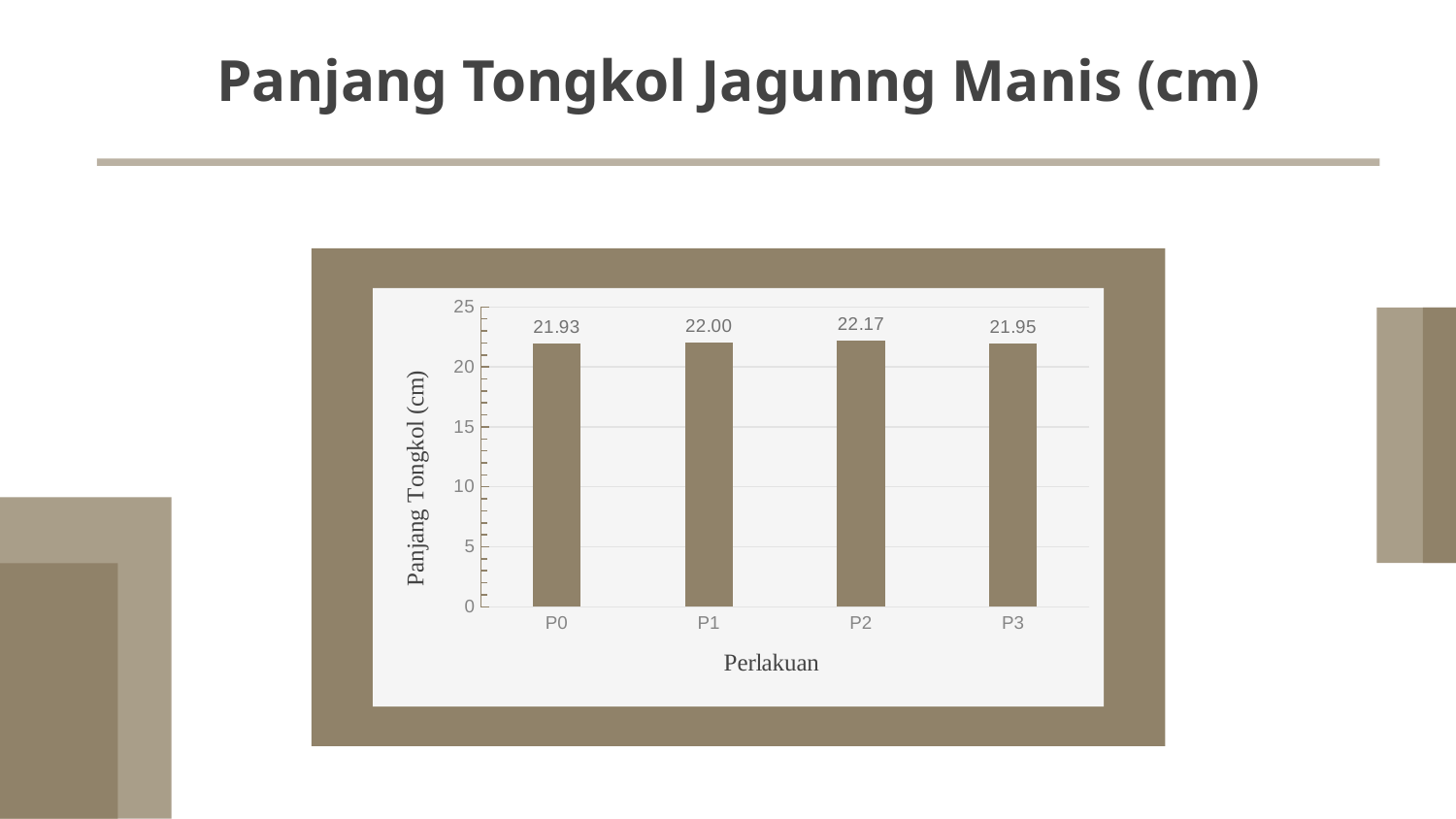
What is the value for P2? 22.17 What kind of chart is shown on the slide? bar chart What is the value for P0? 21.93 Which treatment (Perlakuan) has the lowest value? P0 What is the value for P1? 22.00 How many categories are shown on the x axis? 4 What is the value for P3? 21.95 What is the difference between the values for P2 and P0? 0.24 Which is larger, the value for P3 or the value for P0? P3 Which treatment (Perlakuan) has the highest value? P2 Is the value for P1 greater or less than 20? greater What is the label of the y axis? Panjang Tongkol (cm)